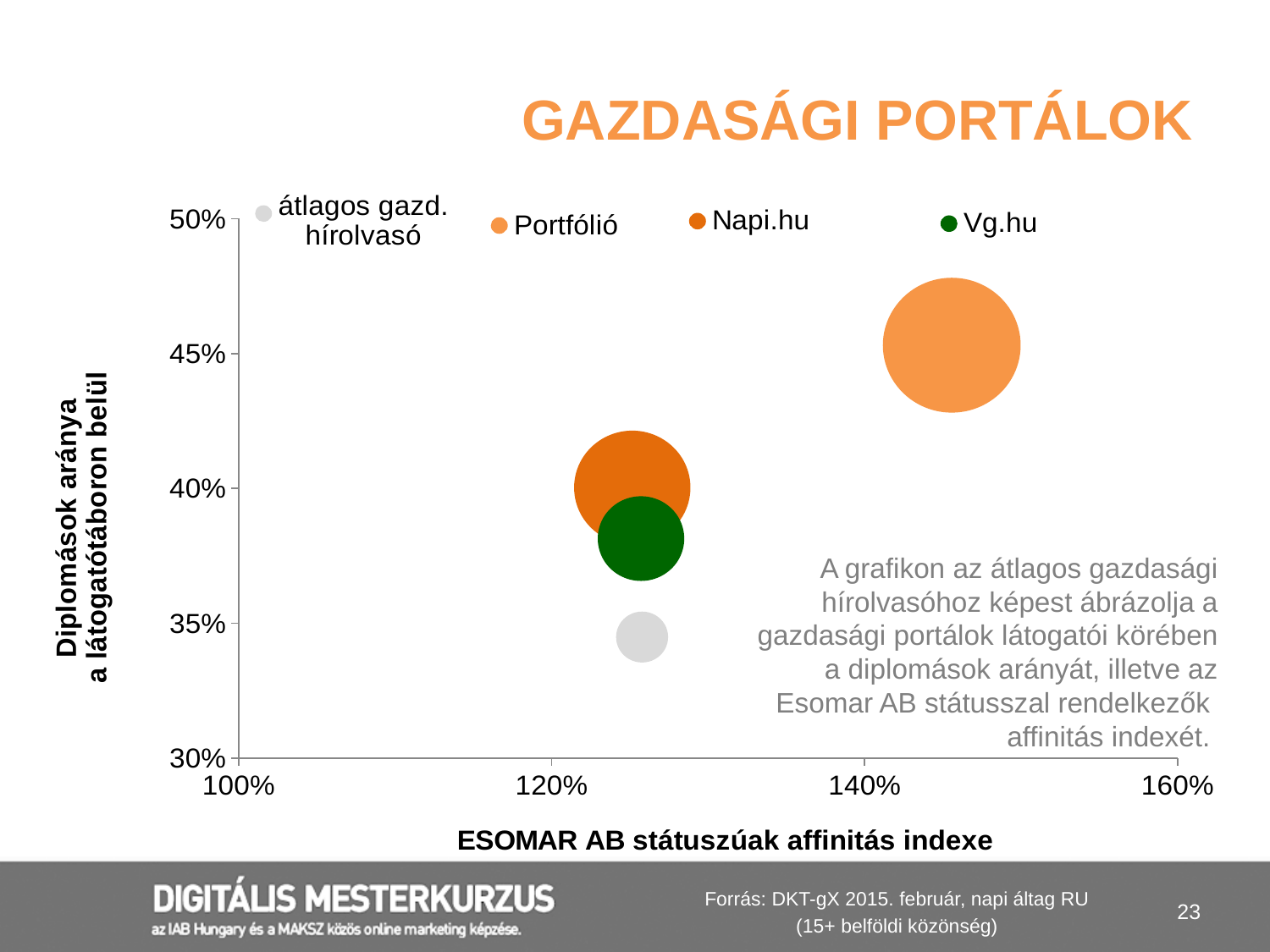
Which has a higher share of graduates, Napi.hu or Vg.hu? Napi.hu Is the share of graduates for Portfólió greater or less than 40%? greater What is the label of the horizontal axis? ESOMAR AB státuszúak affinitás indexe What is the title of the chart? GAZDASÁGI PORTÁLOK Which series has the highest share of graduates (vertical axis)? Portfólió Is the affinity index for Napi.hu greater or less than 140%? less What kind of chart is shown on the slide? bubble chart Which series has the highest ESOMAR AB affinity index (horizontal axis)? Portfólió Which series has the lowest share of graduates (vertical axis)? átlagos gazd. hírolvasó How many series does the legend list? 4 Is the share of graduates for átlagos gazd. hírolvasó greater or less than 40%? less